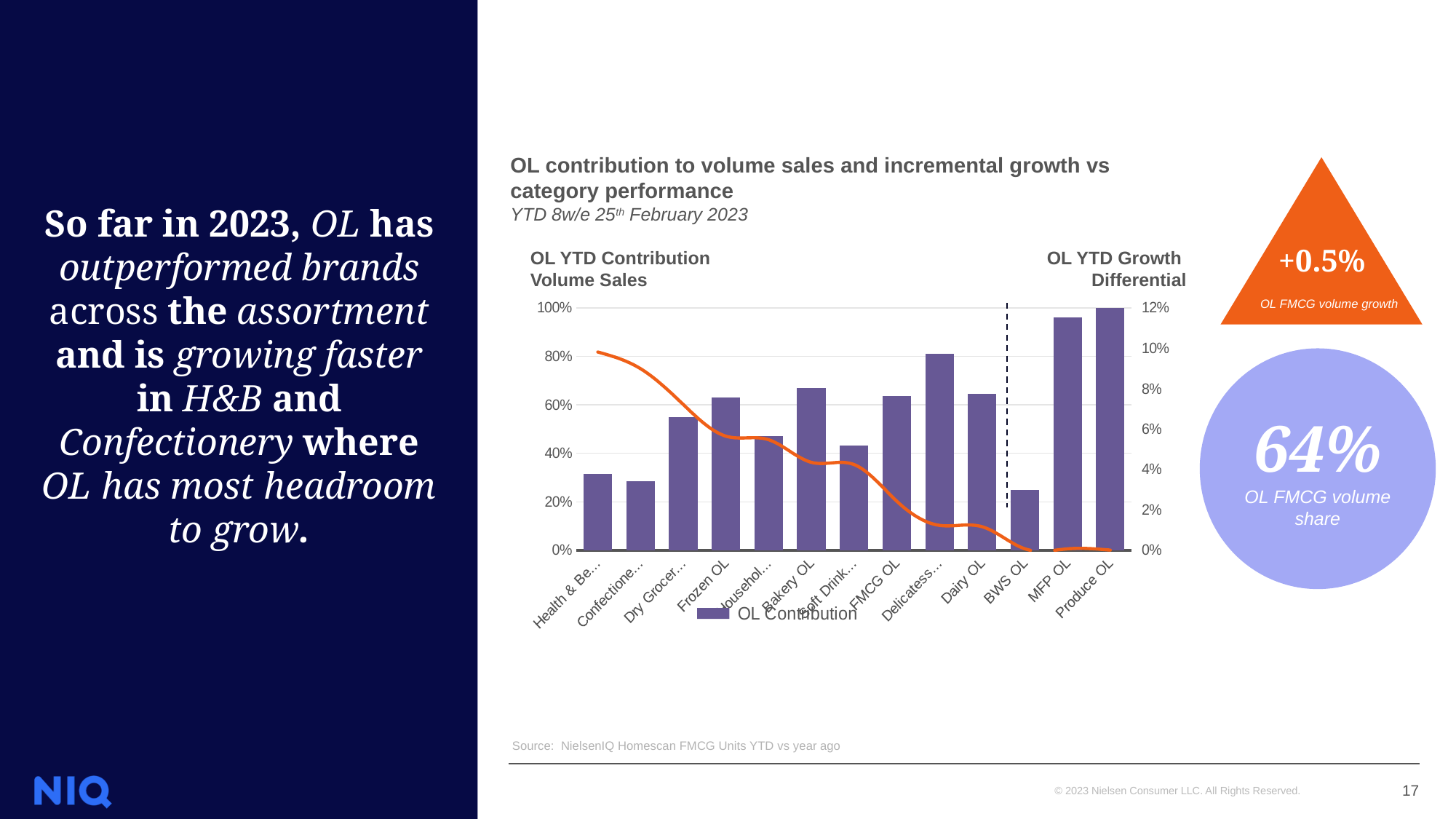
Does the orange OL YTD Growth Differential line rise or fall from left to right across the categories? fall Is the OL Contribution value for Bakery OL greater or less than 60%? greater What is the series name shown in the chart's legend? OL Contribution Which category has the highest OL Contribution bar? Produce OL What kind of chart is shown on the slide? combination bar and line chart Which has a larger OL Contribution bar, Frozen OL or Household? Frozen OL Is the OL Contribution value for Frozen OL greater or less than 60%? greater How many series does the chart's legend list? 1 Is the OL Contribution value for BWS OL greater or less than 40%? less Which has a larger OL Contribution bar, Delicatessen or Dairy OL? Delicatessen How many categories are plotted along the x axis of the chart? 13